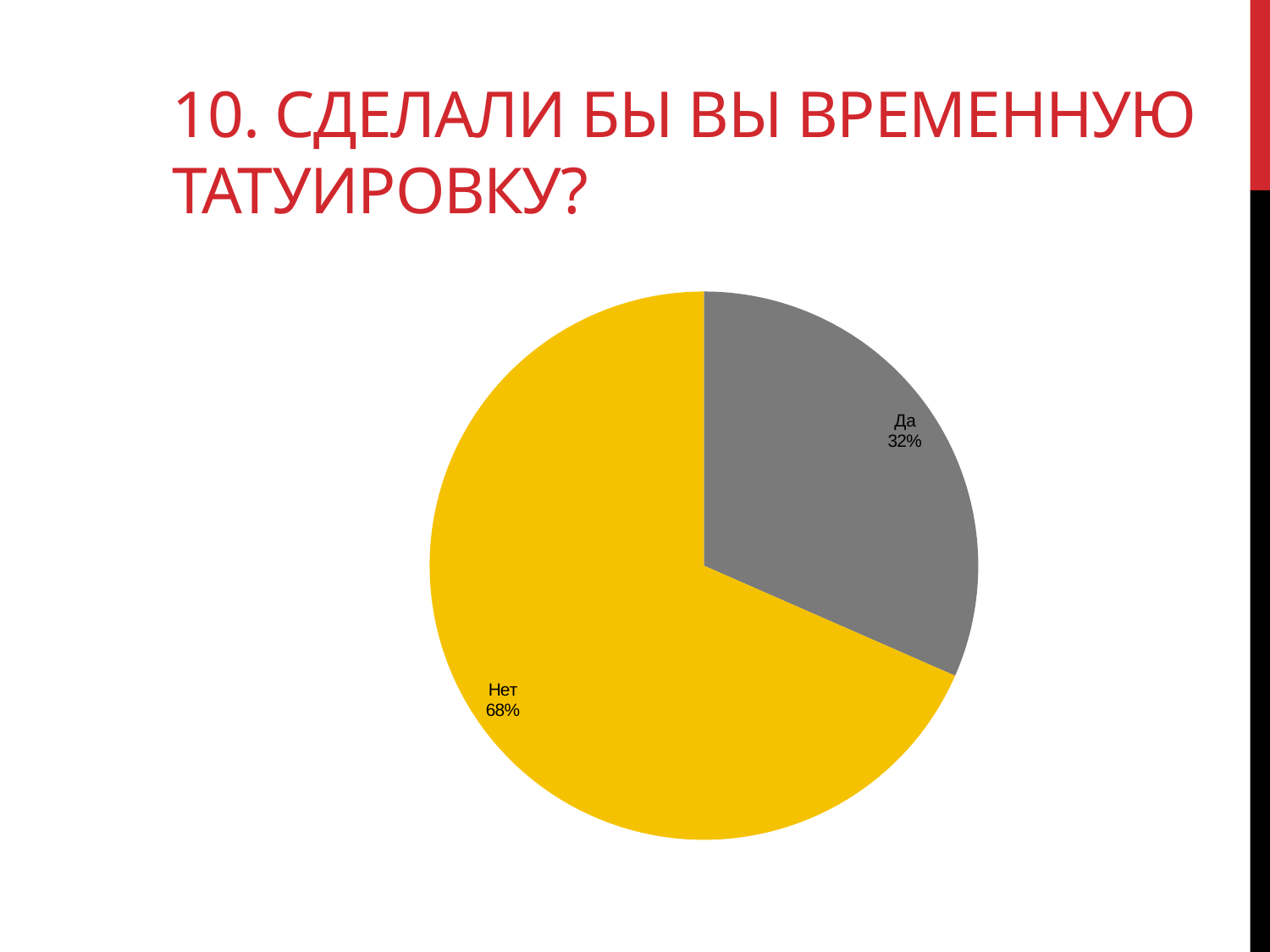
Which slice is the smallest? Да What is the difference in percentage points between the "Нет" and "Да" slices? 36 What colour is the "Да" slice? grey What share of the pie does the "Да" slice represent? 32% Which is larger, the "Да" slice or the "Нет" slice? Нет What share of the pie does the "Нет" slice represent? 68% What kind of chart is shown on the slide? pie chart Which slice is the largest? Нет What colour is the "Нет" slice? yellow How many slices does the pie chart have? 2